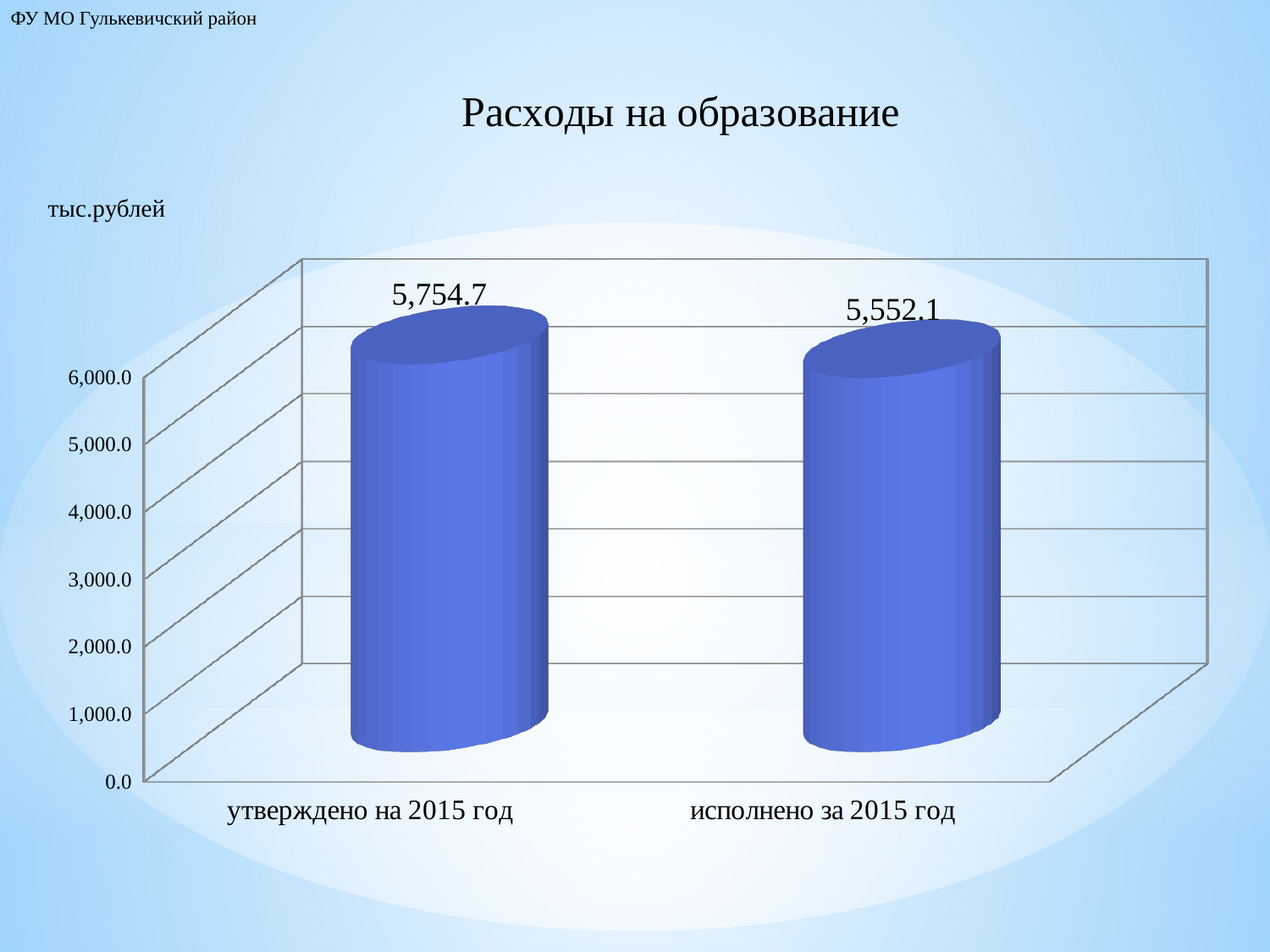
What is the title of the chart? Расходы на образование What is the value for "исполнено за 2015 год"? 5,552.1 Which is larger: the value for "утверждено на 2015 год" or the value for "исполнено за 2015 год"? утверждено на 2015 год Is the value for "исполнено за 2015 год" greater or less than 5,000.0? greater How many categories are shown on the chart? 2 What is the value for "утверждено на 2015 год"? 5,754.7 In what units are the values on the chart expressed? тыс.рублей Which category has the lowest value? исполнено за 2015 год What kind of chart is shown on the slide? bar chart What is the difference between the value for "утверждено на 2015 год" and the value for "исполнено за 2015 год"? 202.6 Which category has the highest value? утверждено на 2015 год Is the value for "утверждено на 2015 год" greater or less than 6,000.0? less